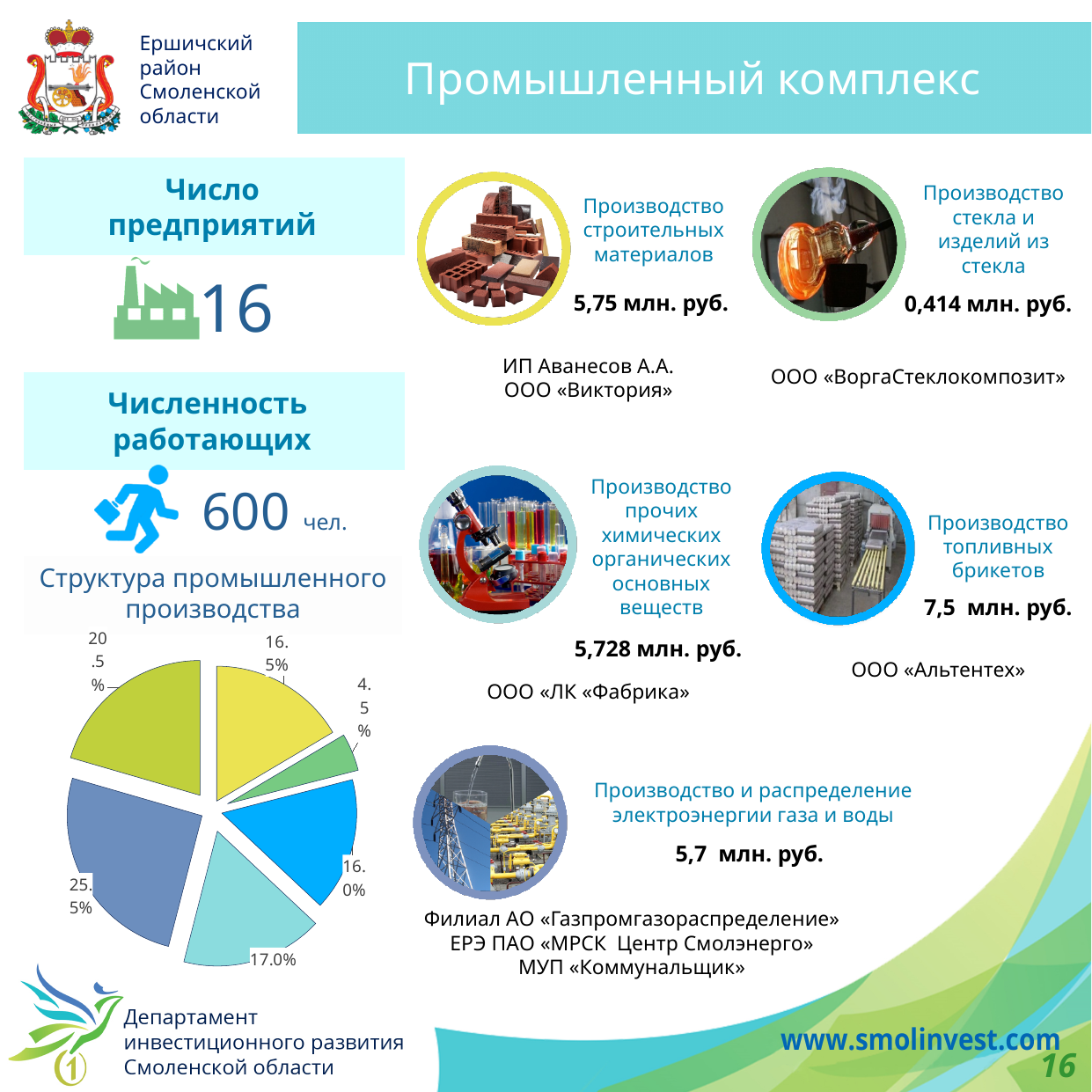
How many slices does the pie chart «Структура промышленного производства» have? 6 On the pie chart «Структура промышленного производства», what percentage is labelled on the dark blue slice? 25.5% On the pie chart «Структура промышленного производства», which is larger: the yellow-green slice or the yellow slice? the yellow-green slice (20.5%) On the pie chart «Структура промышленного производства», what percentage is labelled on the light cyan slice? 17.0% On the pie chart «Структура промышленного производства», what percentage is labelled on the yellow slice? 16.5% On the pie chart «Структура промышленного производства», what is the difference between the 20.5% slice and the 16.0% slice? 4.5 percentage points On the pie chart «Структура промышленного производства», what is the difference in percentage points between the largest slice (25.5%) and the smallest slice (4.5%)? 21 percentage points What kind of chart is shown under the heading «Структура промышленного производства»? pie chart What is the smallest percentage shown on the pie chart «Структура промышленного производства»? 4.5% What is the title of the pie chart on the slide? Структура промышленного производства What is the largest percentage shown on the pie chart «Структура промышленного производства»? 25.5% On the pie chart «Структура промышленного производства», what percentage is labelled on the green slice? 4.5%